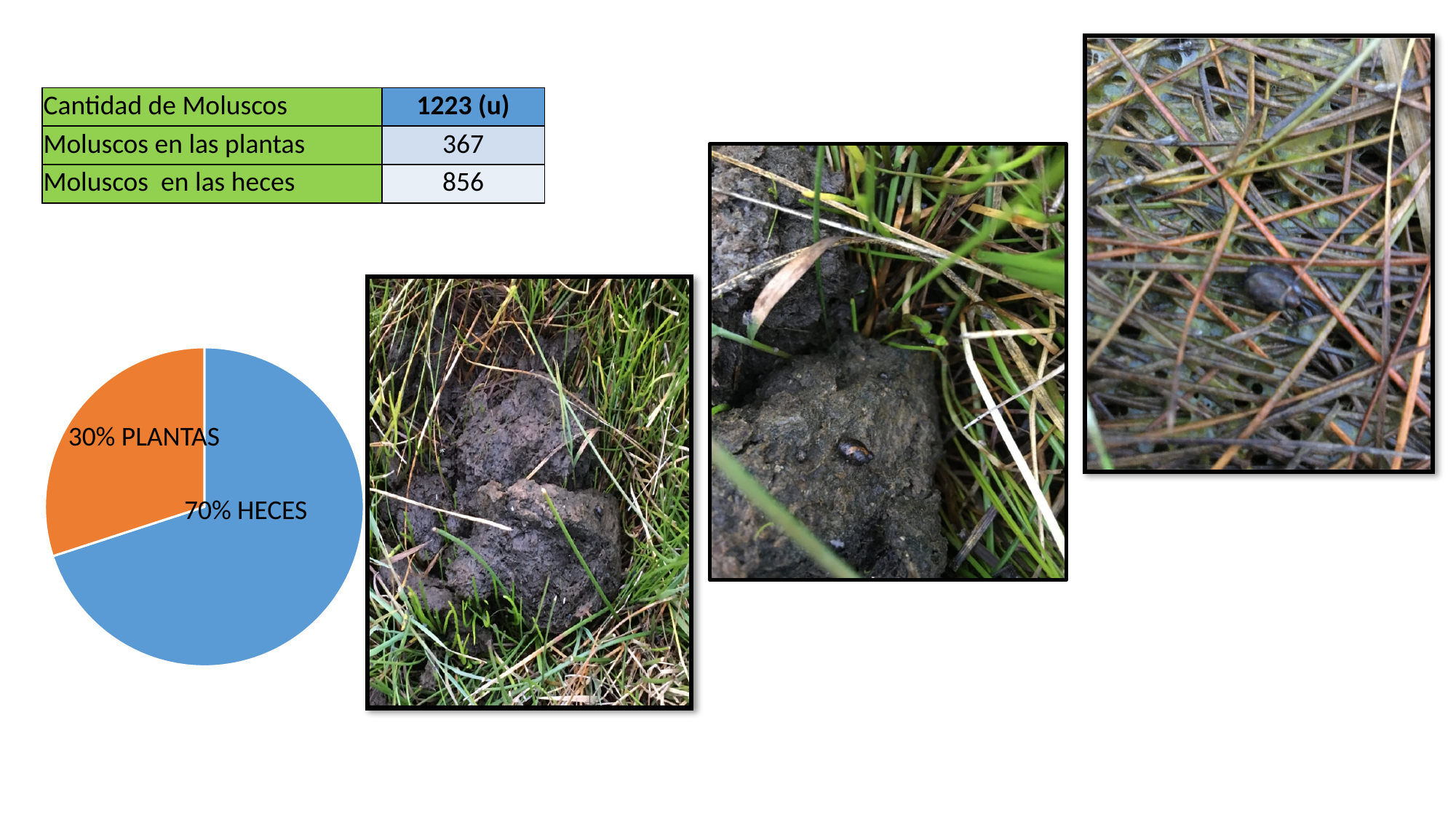
How many slices does the pie chart have? 2 What colour is the PLANTAS slice in the pie chart? orange What kind of chart is shown on the slide? pie chart Which slice of the pie chart is the largest? HECES What share of the pie chart does HECES represent? 70% What share of the pie chart does PLANTAS represent? 30% By how many percentage points does the HECES share exceed the PLANTAS share in the pie chart? 40 Which is larger in the pie chart, the HECES slice or the PLANTAS slice? HECES What colour is the HECES slice in the pie chart? blue Which slice of the pie chart is the smallest? PLANTAS Is the share for PLANTAS in the pie chart greater or less than 50%? less